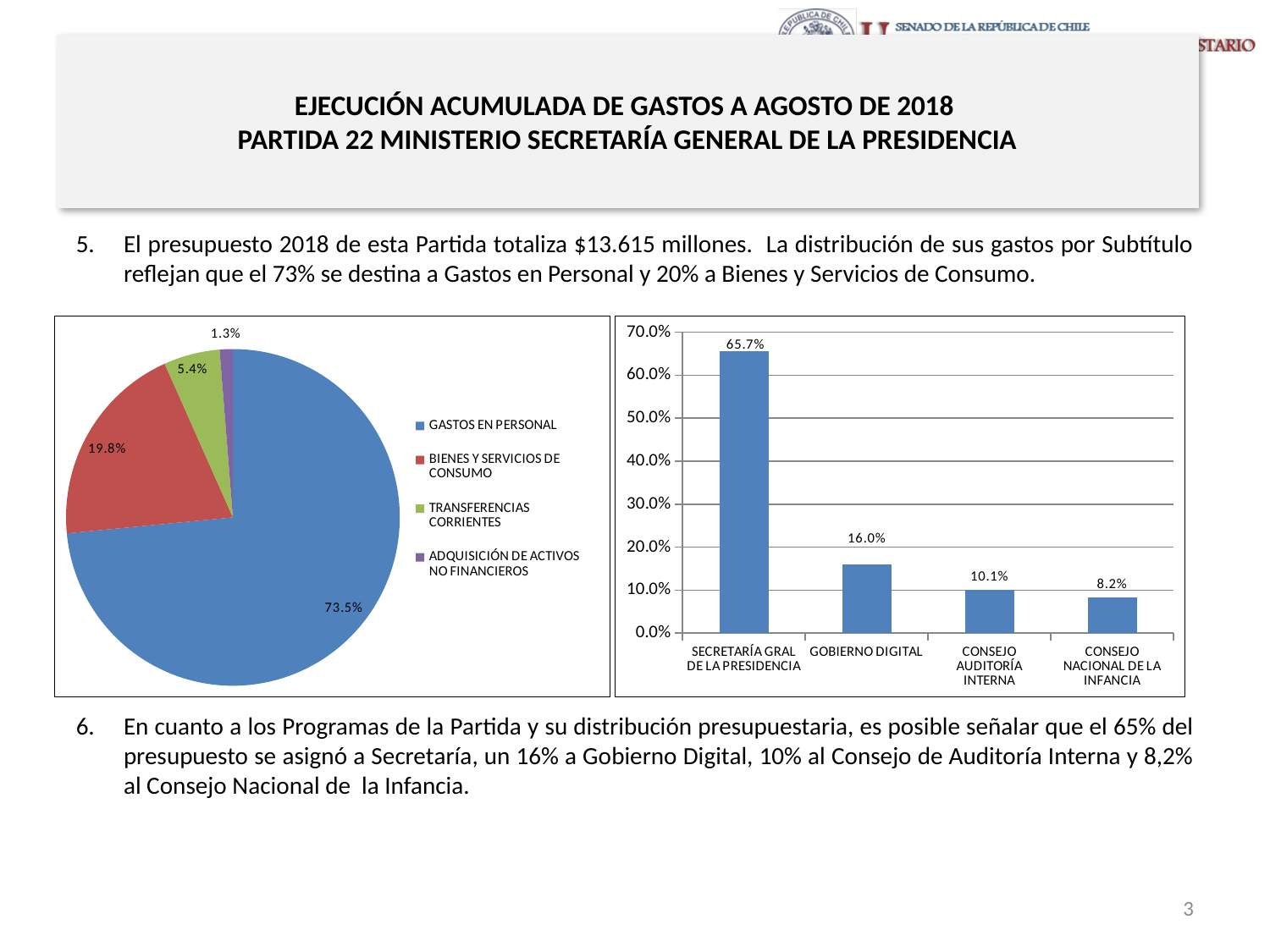
In the bar chart on the right, do the values rise or fall from left to right along the x axis? Fall In the pie chart on the left, how many categories does the legend list? 4 In the pie chart on the left, which category has the smallest slice? ADQUISICIÓN DE ACTIVOS NO FINANCIEROS What type of chart is shown on the right side of the slide? Bar chart In the bar chart on the right, which is larger: CONSEJO AUDITORÍA INTERNA or CONSEJO NACIONAL DE LA INFANCIA? CONSEJO AUDITORÍA INTERNA In the pie chart on the left, what is the difference between the shares of BIENES Y SERVICIOS DE CONSUMO and TRANSFERENCIAS CORRIENTES? 14.4% In the bar chart on the right, what is the value for CONSEJO NACIONAL DE LA INFANCIA? 8.2% In the pie chart on the left, what share does GASTOS EN PERSONAL have? 73.5% In the bar chart on the right, which category has the highest value? SECRETARÍA GRAL DE LA PRESIDENCIA In the bar chart on the right, what is the difference between SECRETARÍA GRAL DE LA PRESIDENCIA and CONSEJO AUDITORÍA INTERNA? 55.6% In the pie chart on the left, what is the value for BIENES Y SERVICIOS DE CONSUMO? 19.8% In the bar chart on the right, what is the value for GOBIERNO DIGITAL? 16.0%